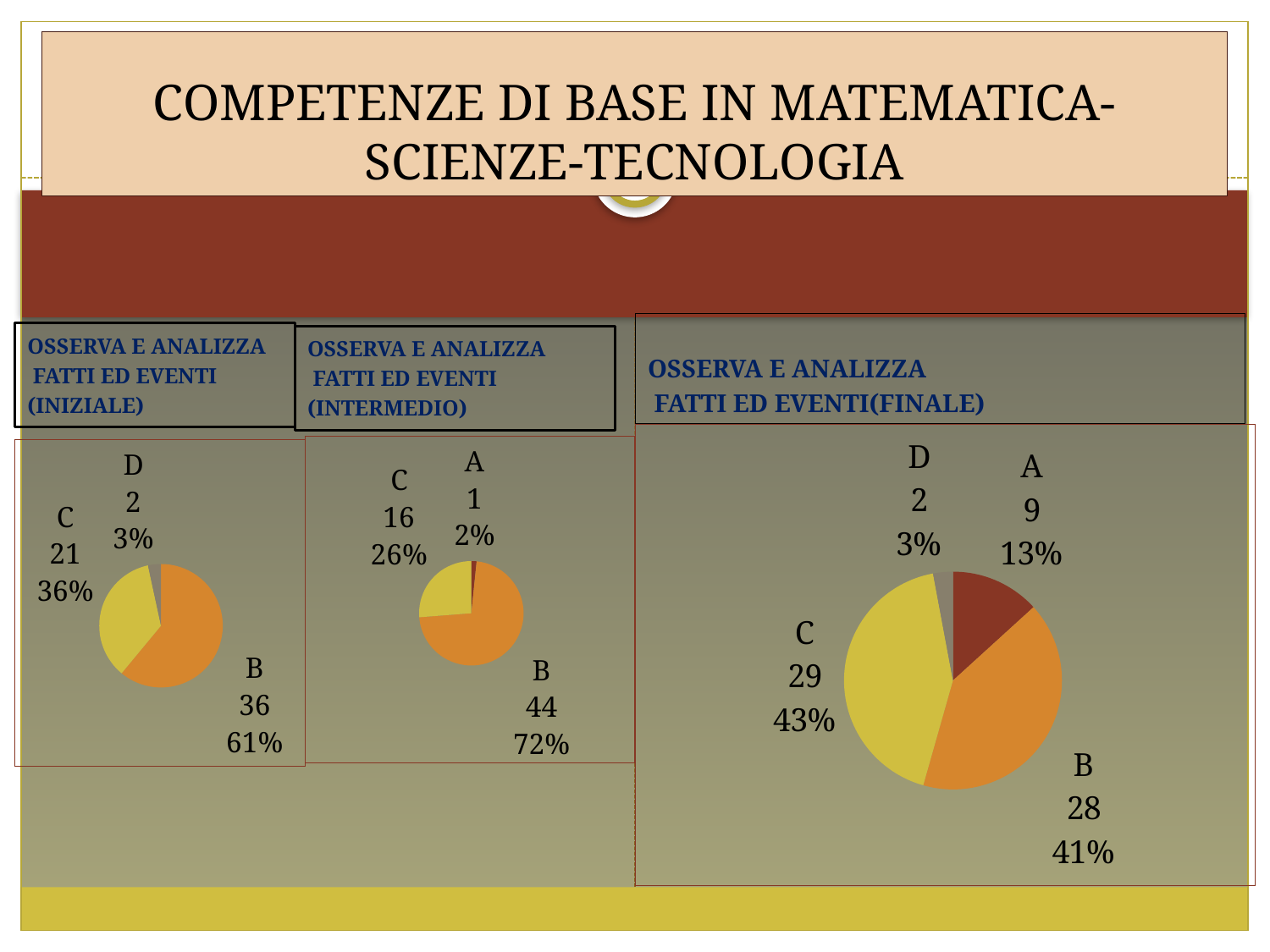
In the INTERMEDIO pie chart, what is the value for category C? 16 In the FINALE pie chart, what is the value for category A? 9 What type of chart is used for the FINALE data? Pie chart In the INIZIALE pie chart, what share of the pie does category C represent? 36% In the FINALE pie chart, what is the difference between the values for C and A? 20 In the FINALE pie chart, how many categories are shown? 4 In the INTERMEDIO pie chart, what share of the pie does category B represent? 72% In the INIZIALE pie chart, which category has the smallest slice? D In the INIZIALE pie chart, what is the value for category B? 36 In the FINALE pie chart, what share of the pie does category C represent? 43% In the INTERMEDIO pie chart, what is the difference between the values for B and C? 28 In the INTERMEDIO pie chart, which category has the largest slice? B